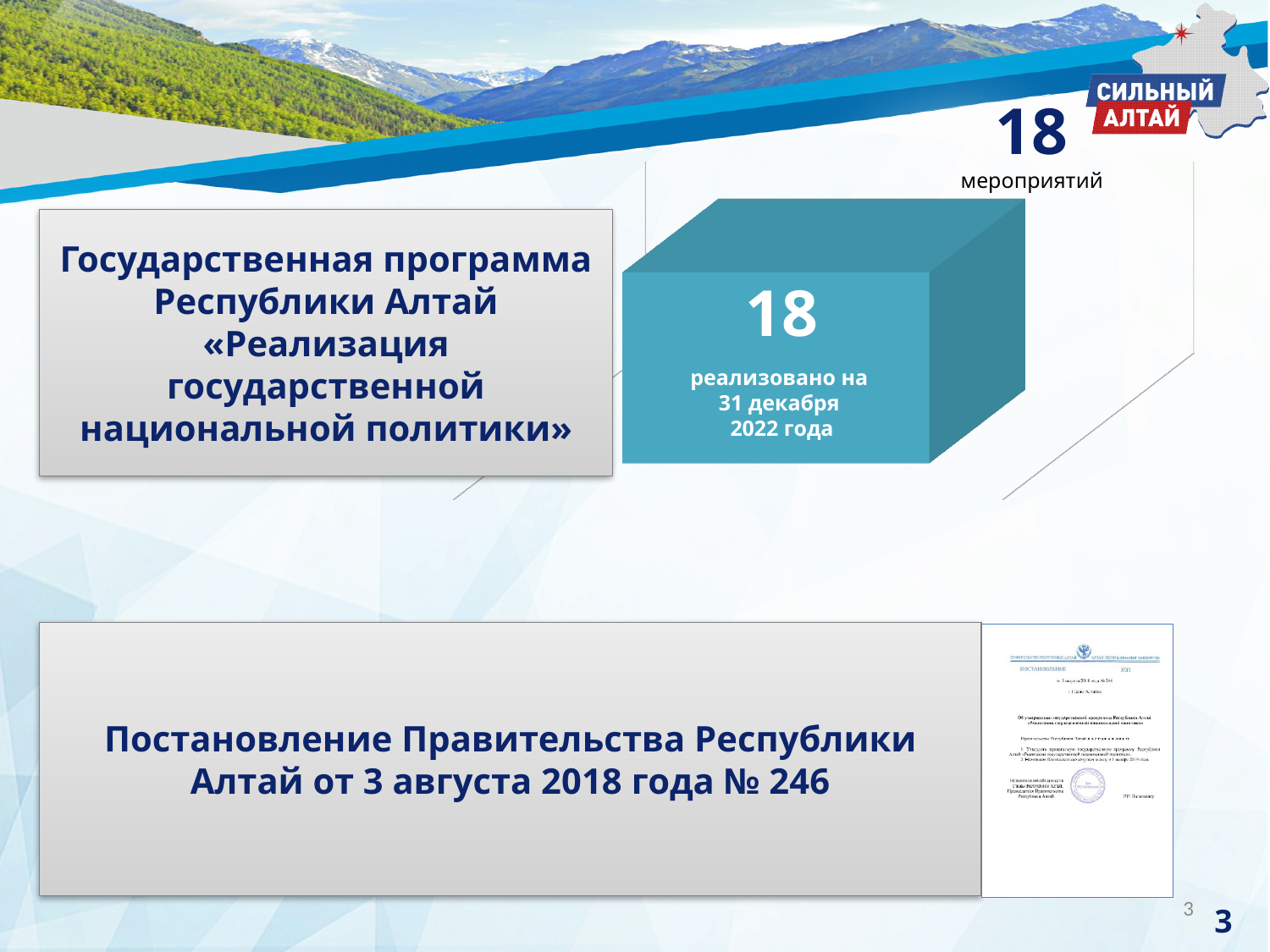
How many bars does the chart on the right of the slide show? 1 According to the label on the bar, by what date were the 18 items realised? 31 декабря 2022 года What kind of chart is shown on the right of the slide? bar chart What value is printed on the 3D bar in the chart on the right of the slide? 18 What total number of мероприятий is printed above the chart? 18